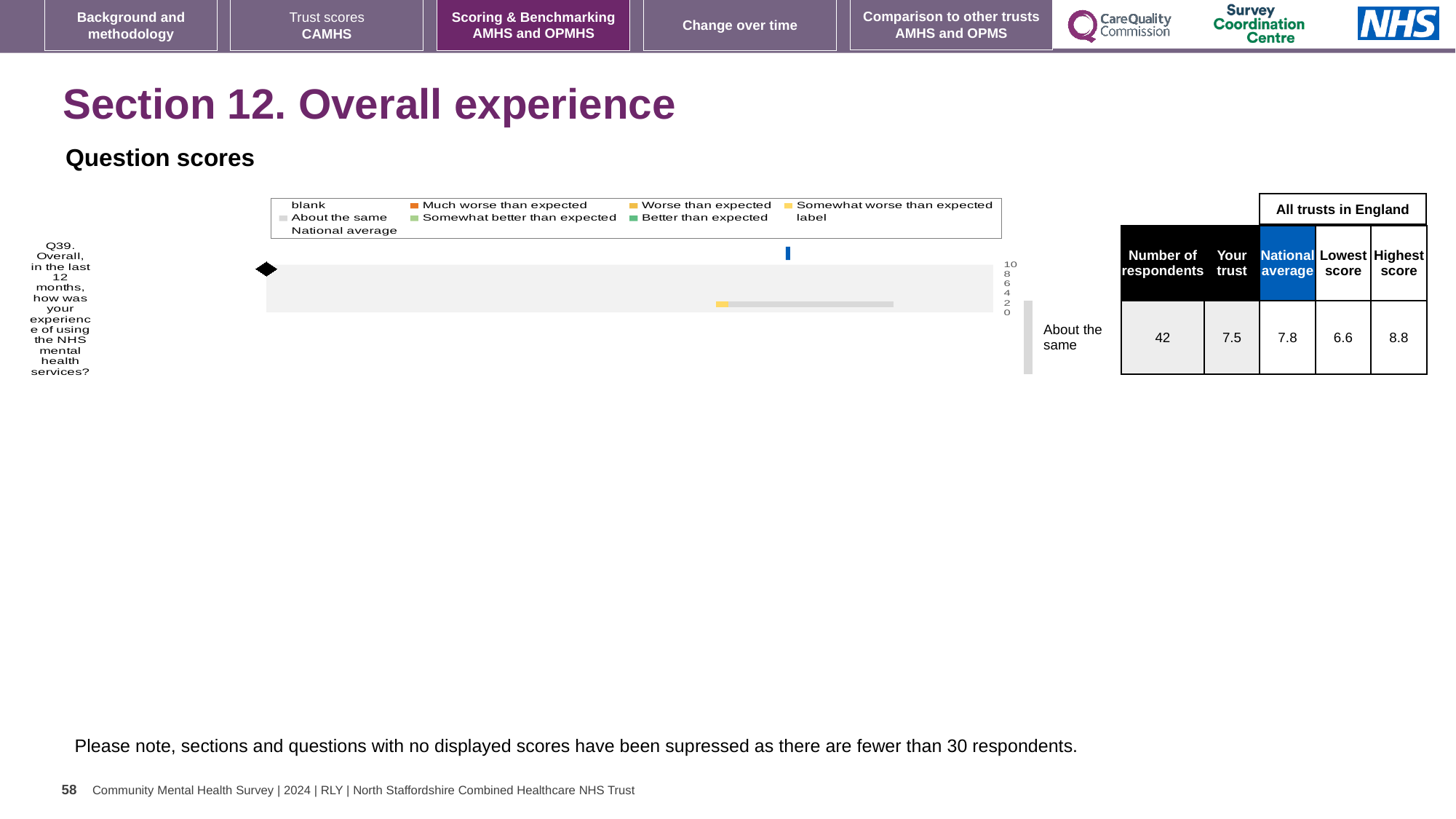
What kind of chart is used to show the Q39 question score? bar chart Which benchmark category is the trust's Q39 score placed in? About the same What is the 'Your trust' score for Q39 (overall experience of using NHS mental health services)? 7.5 By how much does the national average exceed the trust's score for Q39? 0.3 How many respondents answered Q39? 42 What is the maximum value shown on the chart's score axis? 10 What is the lowest score among all trusts in England for Q39? 6.6 What is the highest score among all trusts in England for Q39? 8.8 Which is larger for Q39: the trust's score or the national average? National average How many questions are plotted in the Question scores chart? 1 What is the difference between the highest and lowest trust scores for Q39? 2.2 What is the national average score for Q39? 7.8